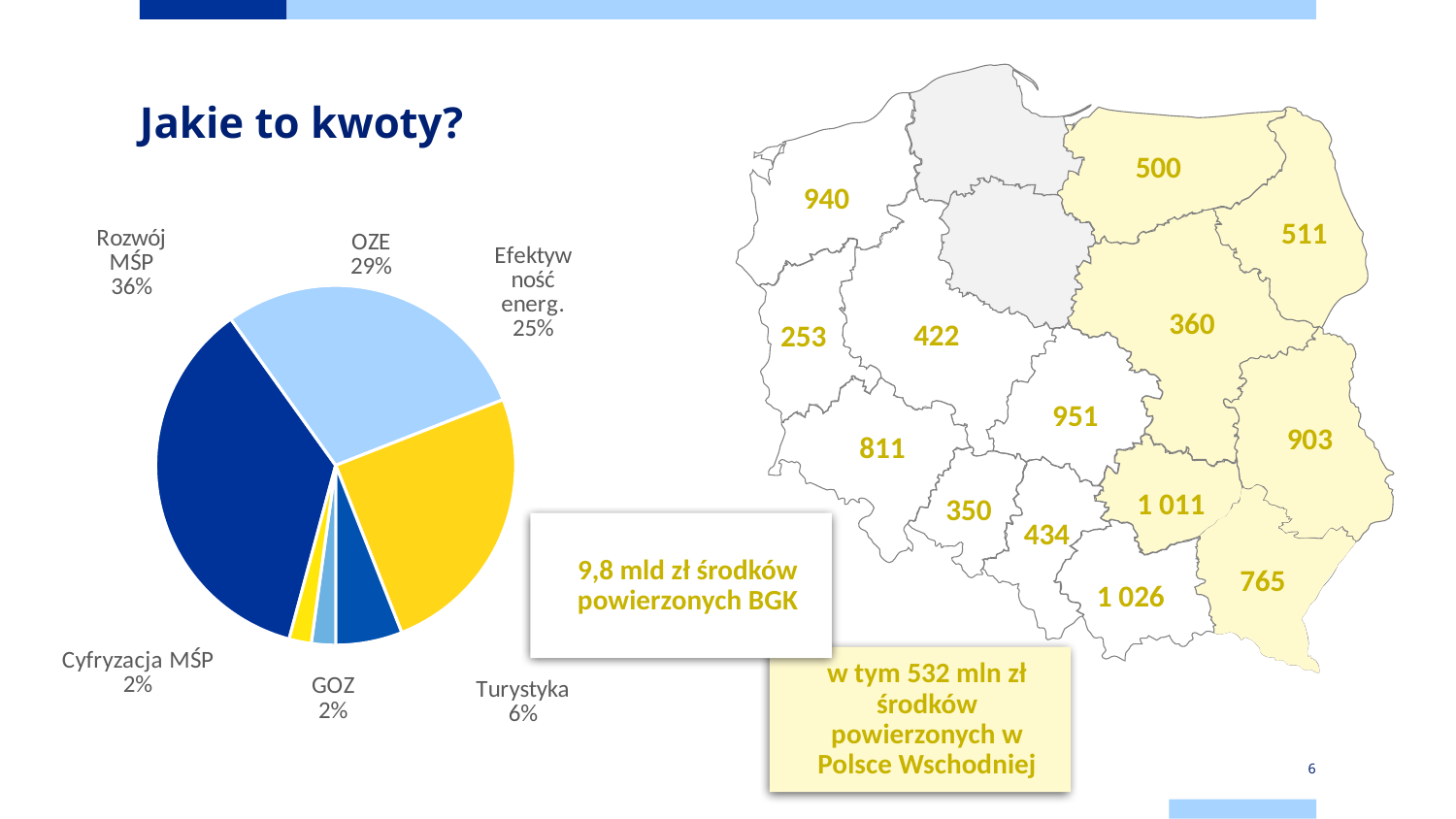
Which category has the largest slice in the pie chart? Rozwój MŚP What share does Efektywność energ. have in the pie chart? 25% What type of chart is shown on the left of the slide? Pie chart What is the difference in percentage points between Rozwój MŚP and OZE in the pie chart? 7 How many categories are shown in the pie chart? 6 What share is shown for GOZ in the pie chart? 2% What share of the pie chart does Rozwój MŚP represent? 36% Which is larger in the pie chart, OZE or Efektywność energ.? OZE What is the difference in percentage points between Efektywność energ. and Turystyka? 19 What percentage of the pie chart is Turystyka? 6% What is the title of the slide containing the pie chart? Jakie to kwoty? What percentage is shown for OZE in the pie chart? 29%